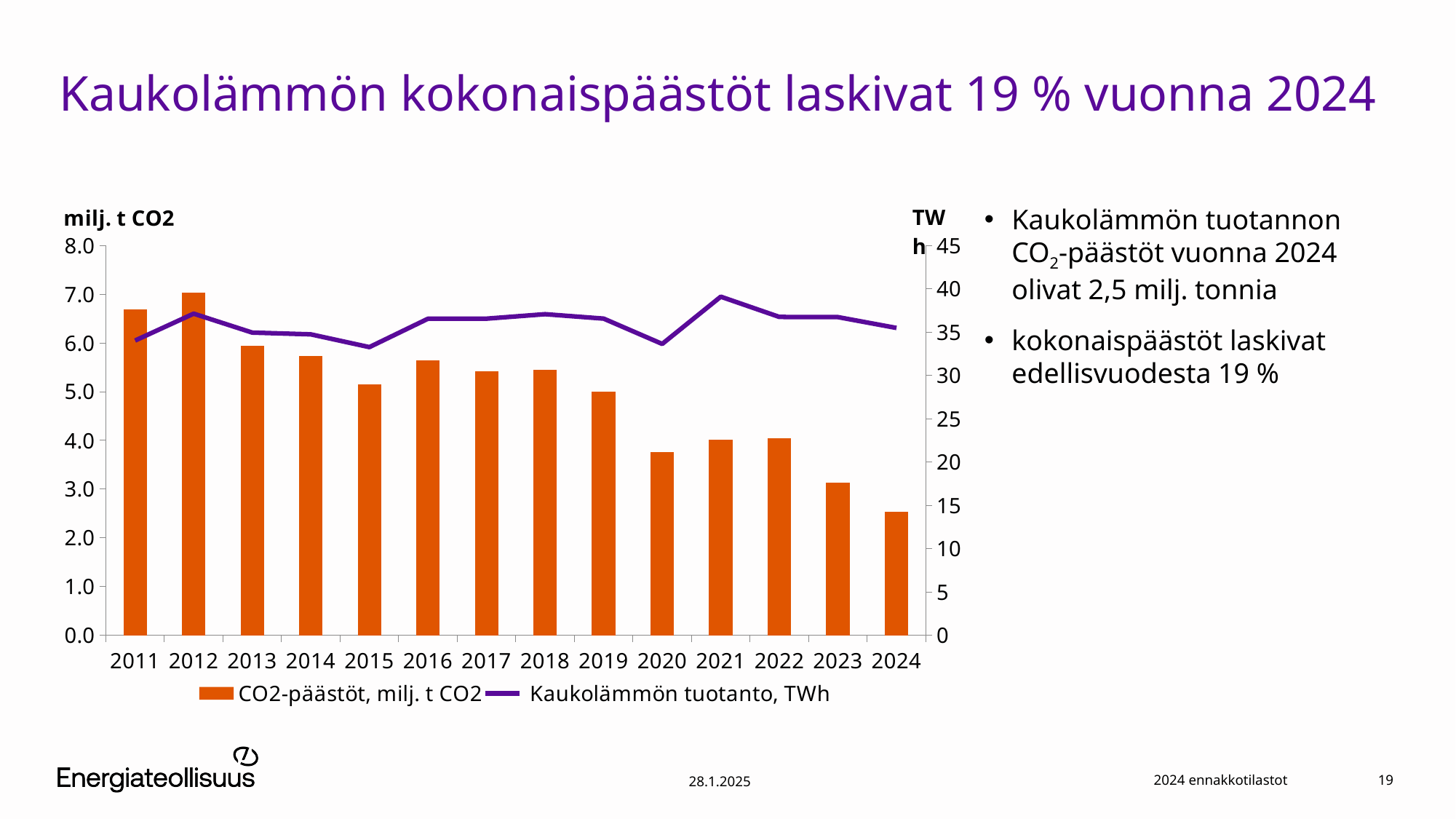
Is the CO2-päästöt value for 2011 greater or less than 6.0? greater Do the CO2-päästöt bars generally rise or fall from 2011 to 2024? fall Which year has the highest bar for CO2-päästöt, milj. t CO2? 2012 How many series does the legend list? 2 Which year has the lowest bar for CO2-päästöt, milj. t CO2? 2024 Is the CO2-päästöt value for 2024 greater or less than 3.0? less In which year does the Kaukolämmön tuotanto, TWh line reach its highest point? 2021 What kind of chart is shown on the slide? A combined bar and line chart Is the CO2-päästöt value for 2020 greater or less than 4.0? less How many years are shown on the x axis? 14 Which year has the larger CO2-päästöt bar, 2011 or 2024? 2011